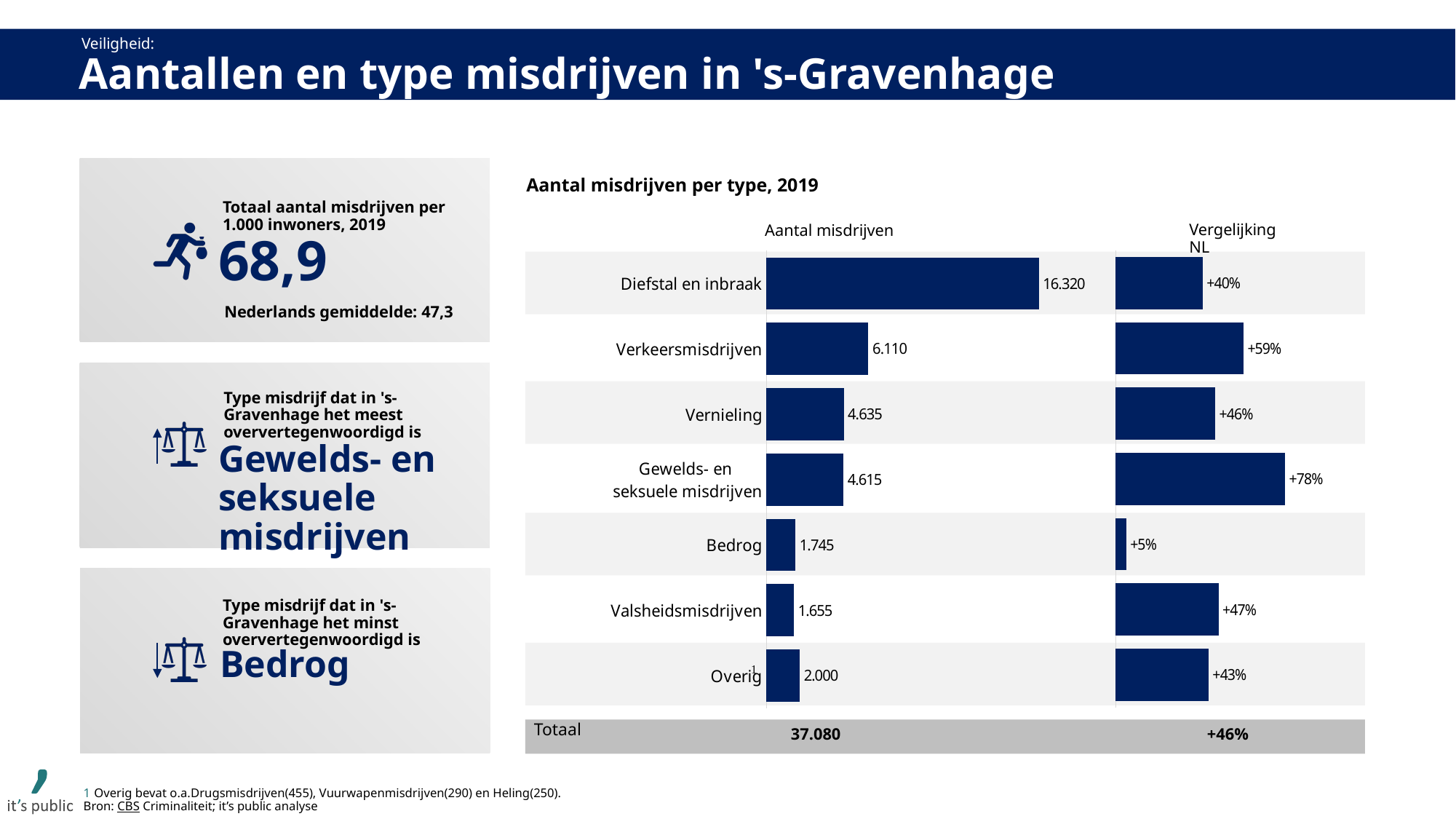
In the chart 'Aantal misdrijven per type, 2019', which crime type has the highest 'Aantal misdrijven'? Diefstal en inbraak In the chart 'Aantal misdrijven per type, 2019', which crime type has the lowest 'Vergelijking NL' percentage? Bedrog What are the two column headings in the chart 'Aantal misdrijven per type, 2019'? Aantal misdrijven and Vergelijking NL In the chart 'Aantal misdrijven per type, 2019', what is the 'Aantal misdrijven' value for Verkeersmisdrijven? 6.110 In the chart 'Aantal misdrijven per type, 2019', which has a higher 'Vergelijking NL' percentage: Verkeersmisdrijven or Vernieling? Verkeersmisdrijven In the chart 'Aantal misdrijven per type, 2019', what is the Totaal value for 'Aantal misdrijven'? 37.080 In the chart 'Aantal misdrijven per type, 2019', what is the difference in 'Aantal misdrijven' between Diefstal en inbraak and Verkeersmisdrijven? 10.210 How many crime types (excluding the Totaal row) are shown in the chart 'Aantal misdrijven per type, 2019'? 7 What type of chart is 'Aantal misdrijven per type, 2019'? Bar chart In the chart 'Aantal misdrijven per type, 2019', which crime type has the lowest 'Aantal misdrijven'? Valsheidsmisdrijven In the chart 'Aantal misdrijven per type, 2019', what is the 'Aantal misdrijven' value for Diefstal en inbraak? 16.320 In the chart 'Aantal misdrijven per type, 2019', what is the 'Vergelijking NL' value for Gewelds- en seksuele misdrijven? +78%